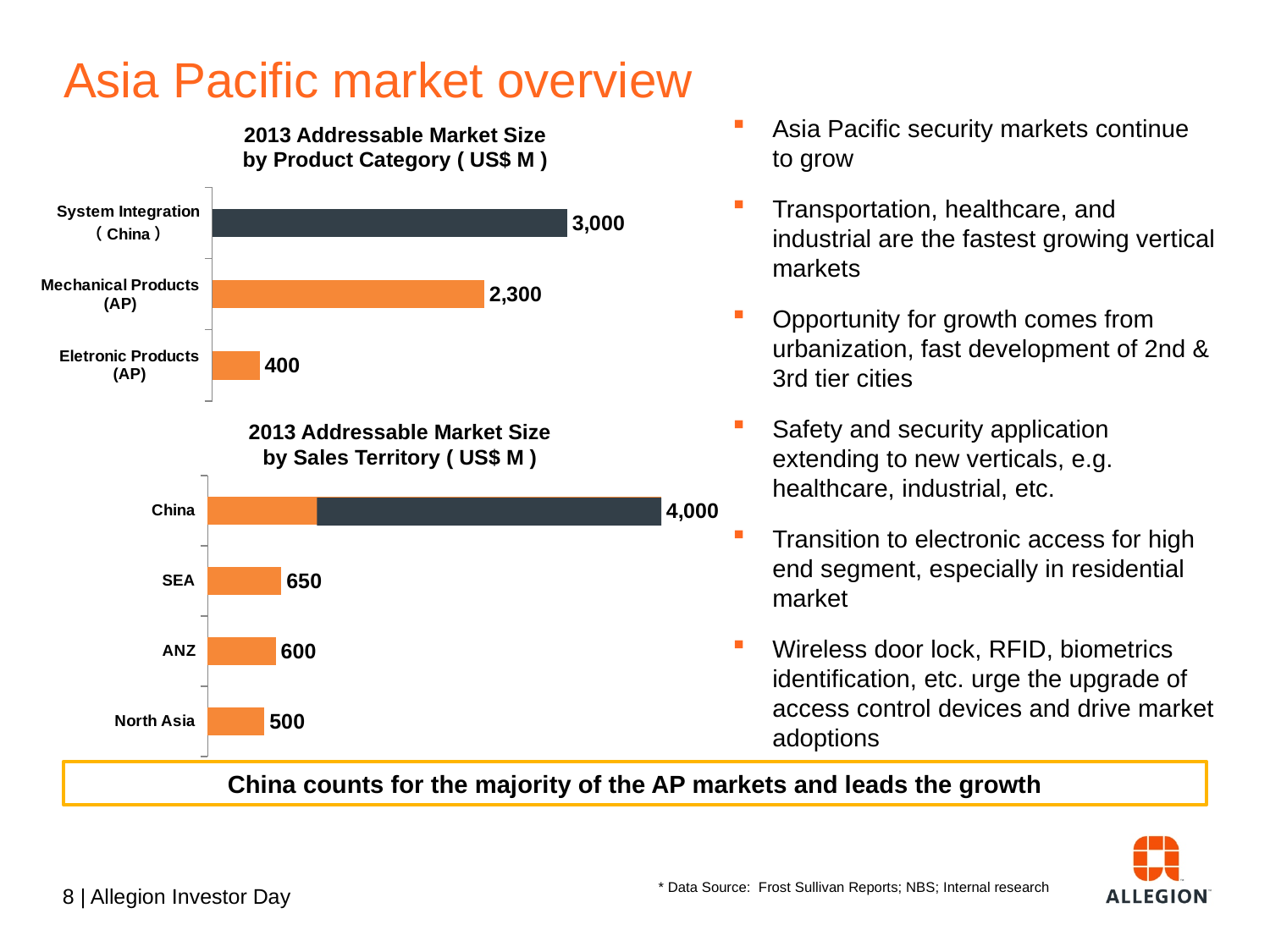
In the '2013 Addressable Market Size by Sales Territory' chart, how many sales territories are shown? 4 In the '2013 Addressable Market Size by Product Category' chart, how many product categories are shown? 3 In the '2013 Addressable Market Size by Product Category' chart, what is the value for Eletronic Products (AP)? 400 In the '2013 Addressable Market Size by Product Category' chart, what is the difference between System Integration (China) and Mechanical Products (AP)? 700 In the '2013 Addressable Market Size by Product Category' chart, what is the value for Mechanical Products (AP)? 2,300 In the '2013 Addressable Market Size by Sales Territory' chart, which territory has the lowest value? North Asia In the '2013 Addressable Market Size by Sales Territory' chart, what is the difference between SEA and North Asia? 150 In the '2013 Addressable Market Size by Sales Territory' chart, which is larger, SEA or ANZ? SEA In the '2013 Addressable Market Size by Sales Territory' chart, what is the value for China? 4,000 In the '2013 Addressable Market Size by Sales Territory' chart, what is the value for North Asia? 500 What type of chart is the '2013 Addressable Market Size by Sales Territory' chart? Bar chart In the '2013 Addressable Market Size by Product Category' chart, which category has the highest value? System Integration (China)